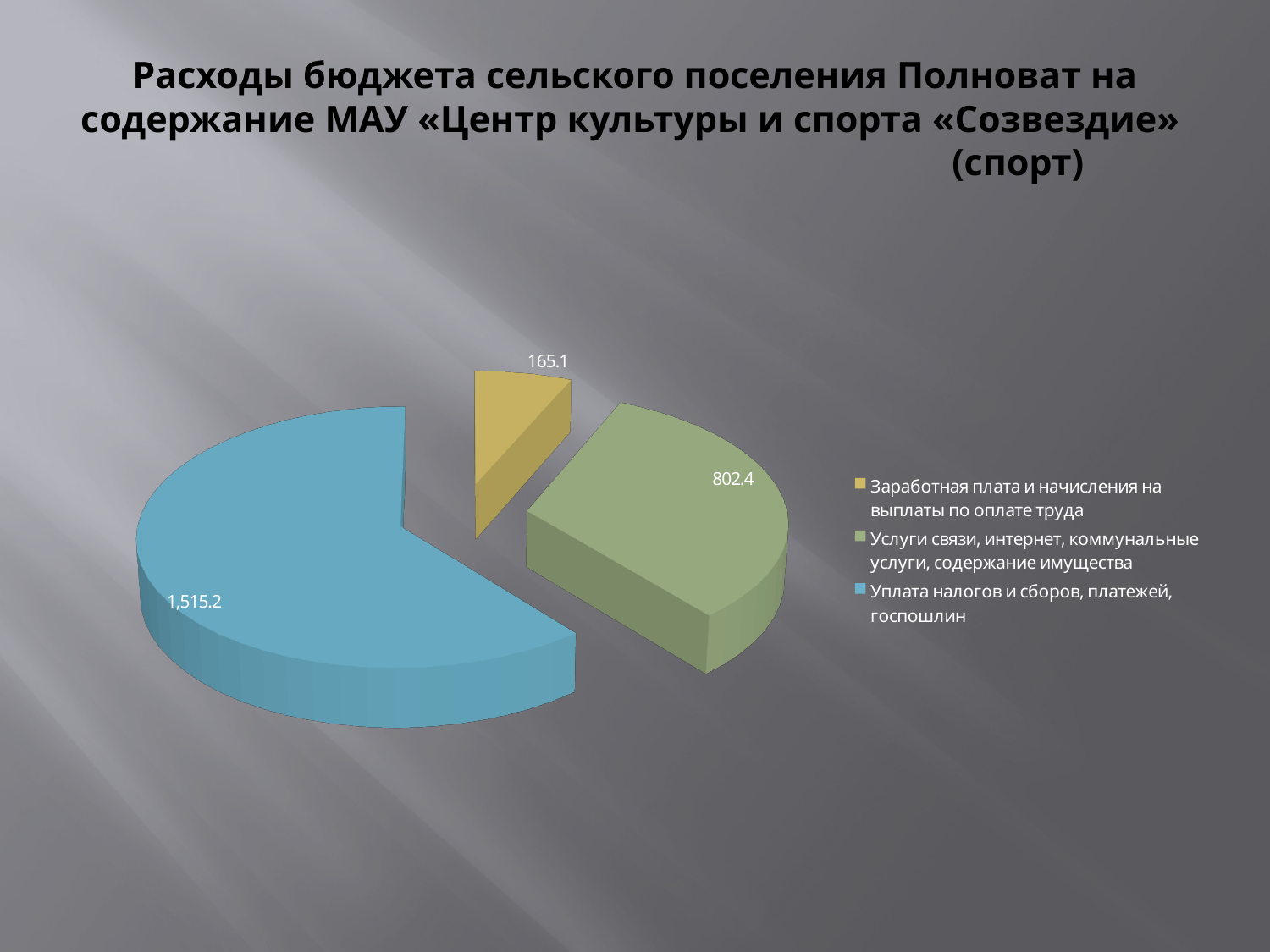
What type of chart is shown on the slide? pie chart What is the total of all three slices in the pie chart? 2,482.7 What is the value for «Услуги связи, интернет, коммунальные услуги, содержание имущества»? 802.4 What colour is the slice for «Уплата налогов и сборов, платежей, госпошлин»? blue How many entries does the legend list? 3 Which category has the largest slice of the pie? Уплата налогов и сборов, платежей, госпошлин Which category has the smallest slice of the pie? Заработная плата и начисления на выплаты по оплате труда What is the value for «Заработная плата и начисления на выплаты по оплате труда»? 165.1 How many slices does the pie chart have? 3 Which is larger: the value for «Услуги связи, интернет, коммунальные услуги, содержание имущества» or for «Заработная плата и начисления на выплаты по оплате труда»? Услуги связи, интернет, коммунальные услуги, содержание имущества What is the difference between the values for «Уплата налогов и сборов, платежей, госпошлин» and «Услуги связи, интернет, коммунальные услуги, содержание имущества»? 712.8 What is the value for «Уплата налогов и сборов, платежей, госпошлин»? 1,515.2